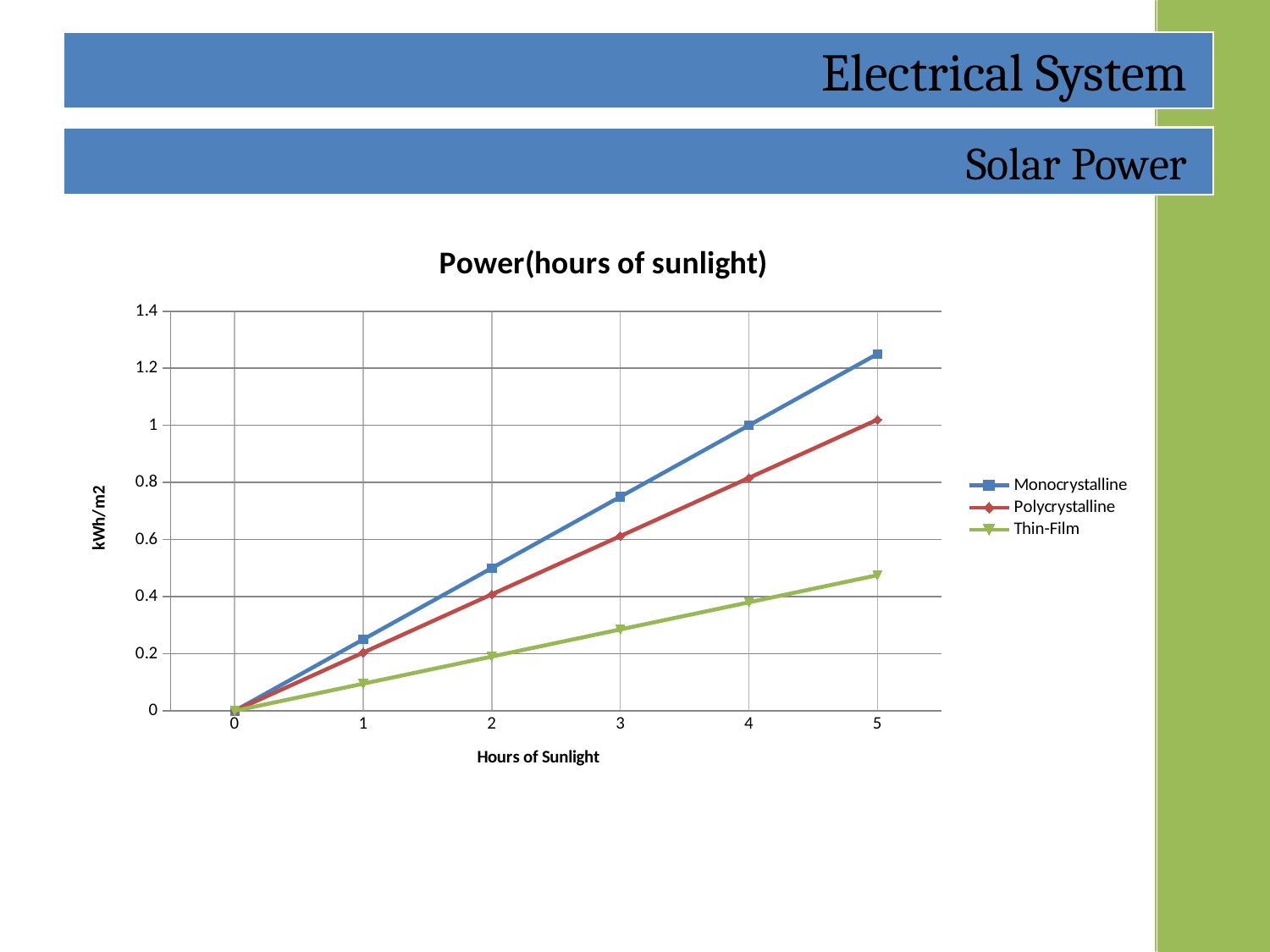
How many series does the legend list? 3 What kind of chart is shown on the slide? line chart Is the value for Thin-Film at 5 hours of sunlight greater or less than 0.6? less How many hours-of-sunlight points are plotted for each series? 6 What is the value for Thin-Film at 0 hours of sunlight? 0 What is the label on the y axis? kWh/m2 Do the values for Polycrystalline rise or fall as hours of sunlight increase? rise Which series has the lowest value at 5 hours of sunlight? Thin-Film What is the value for Monocrystalline at 4 hours of sunlight? 1 Is the value for Monocrystalline at 5 hours of sunlight greater or less than 1.2? greater Which series has the highest value at 5 hours of sunlight? Monocrystalline At 3 hours of sunlight, which is larger: Polycrystalline or Thin-Film? Polycrystalline